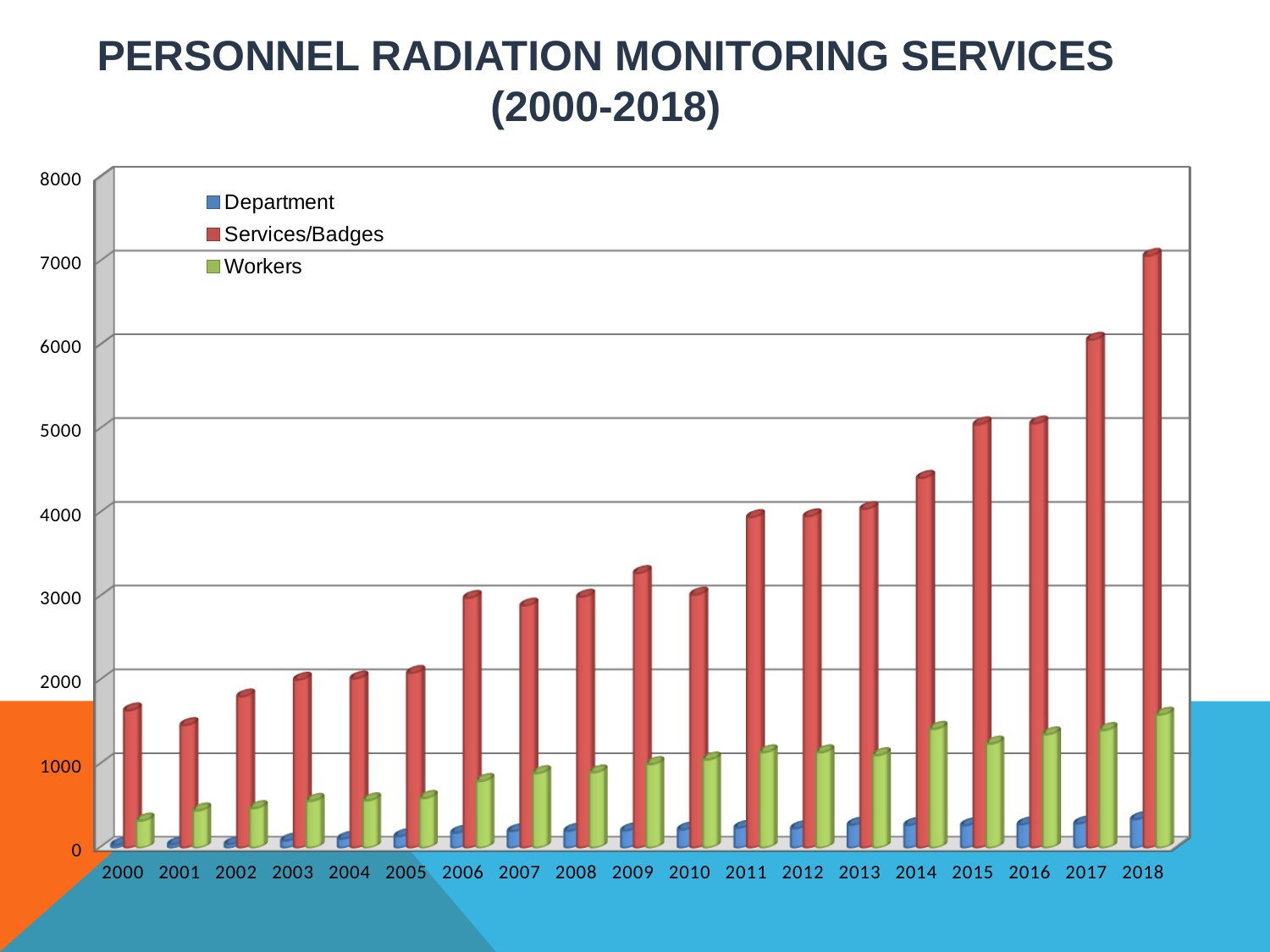
Is the Workers value for 2018 greater or less than 1000? greater Is the Services/Badges value for 2006 greater or less than 4000? less Do the Services/Badges values generally rise or fall from 2000 to 2018? rise What kind of chart is shown on the slide? bar chart Which year has the highest Workers value? 2018 How many years are shown along the x axis? 19 Which year has the highest Services/Badges value? 2018 Which year has the larger Services/Badges value, 2016 or 2017? 2017 Is the Services/Badges value for 2018 greater or less than 6000? greater Which year has the lowest Services/Badges value? 2001 How many series does the legend list? 3